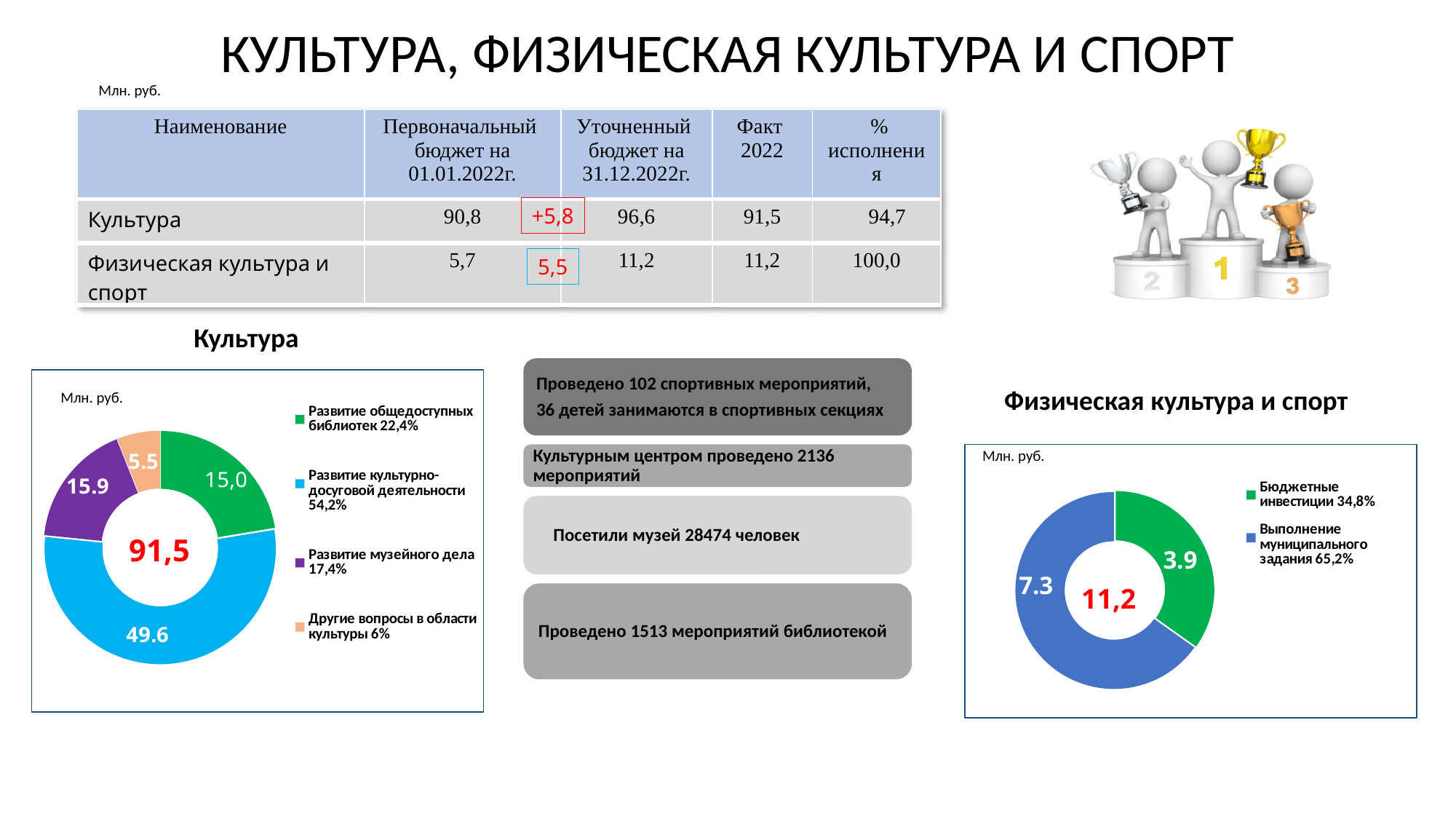
In the "Физическая культура и спорт" chart, what is the value for "Выполнение муниципального задания"? 7.3 In the "Культура" chart, what is the value for "Развитие общедоступных библиотек"? 15,0 How many categories does the "Культура" chart show? 4 In the "Культура" chart, what is the value for "Развитие культурно-досуговой деятельности"? 49.6 What kind of chart is the "Культура" chart on the left of the slide? Donut (pie) chart In the "Физическая культура и спорт" chart, what is the value for "Бюджетные инвестиции"? 3.9 In the "Физическая культура и спорт" chart, which is larger: "Бюджетные инвестиции" or "Выполнение муниципального задания"? Выполнение муниципального задания In the "Культура" chart, what share of the total does "Развитие музейного дела" account for, according to the legend? 17,4% In the "Культура" chart, which category has the largest value? Развитие культурно-досуговой деятельности In the "Физическая культура и спорт" chart, what share does "Бюджетные инвестиции" account for, according to the legend? 34,8% In the "Культура" chart, which category has the smallest value? Другие вопросы в области культуры In the "Культура" chart, what is the value for "Развитие музейного дела"? 15.9